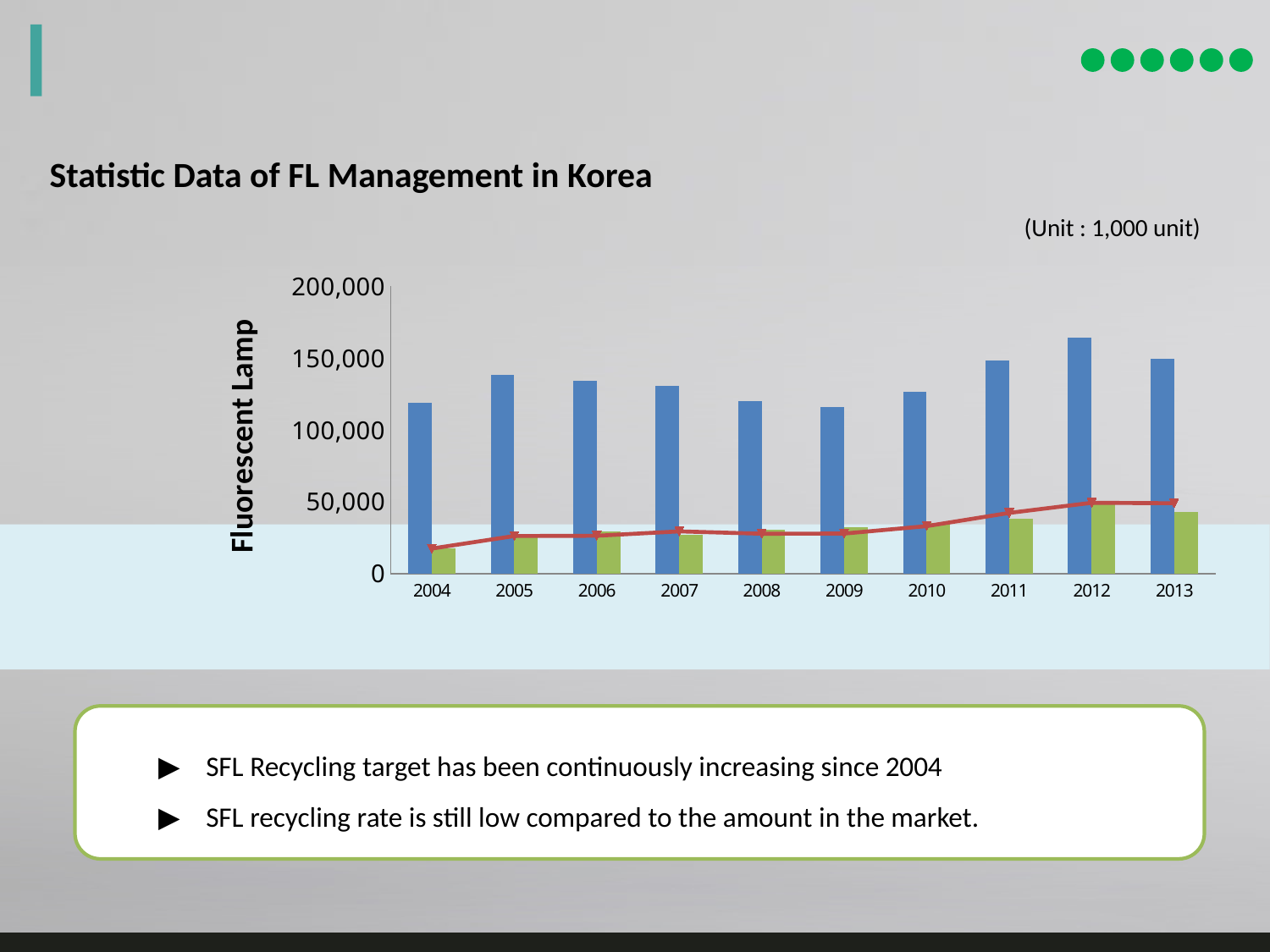
Does the red line generally rise or fall from 2004 to 2013? rise How many years are shown on the x axis of the chart? 10 Is the blue bar for 2012 greater or less than 150,000? greater Is the blue bar for 2009 greater or less than 100,000? greater In which year is the green bar the highest? 2012 In which year is the green bar the lowest? 2004 What is the title of the chart on the slide? Statistic Data of FL Management in Korea Which is larger, the blue bar for 2011 or the blue bar for 2012? 2012 What unit is stated for the values in the chart? 1,000 unit In which year is the blue bar the highest? 2012 Is the green bar for 2004 greater or less than 50,000? less What kind of chart is shown on the slide? Bar chart with a line series